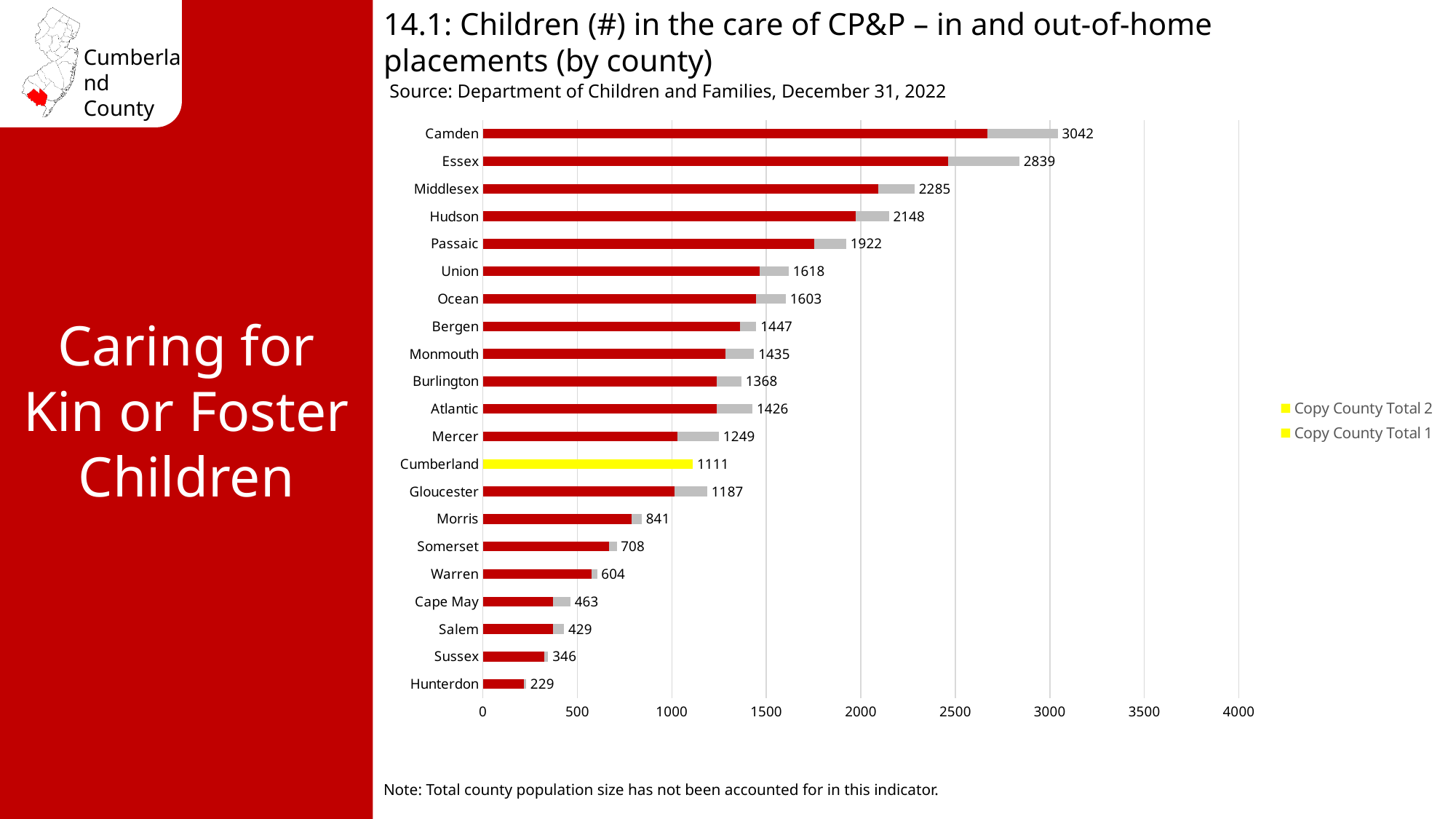
Which county has the highest total number of children in the care of CP&P? Camden What is the total value shown for Camden county? 3042 What kind of chart is shown on the slide? Bar chart How many counties are shown in the chart? 21 Which county's bar is highlighted in yellow? Cumberland Which county has a larger total, Atlantic or Burlington? Atlantic Is the total value for Passaic greater or less than 2000? less What is the difference between the totals for Camden and Essex? 203 What is the total value shown for Gloucester county? 1187 How many series does the legend list? 2 Which county has the lowest total number of children in the care of CP&P? Hunterdon What is the total number of children in the care of CP&P shown for Cumberland county? 1111